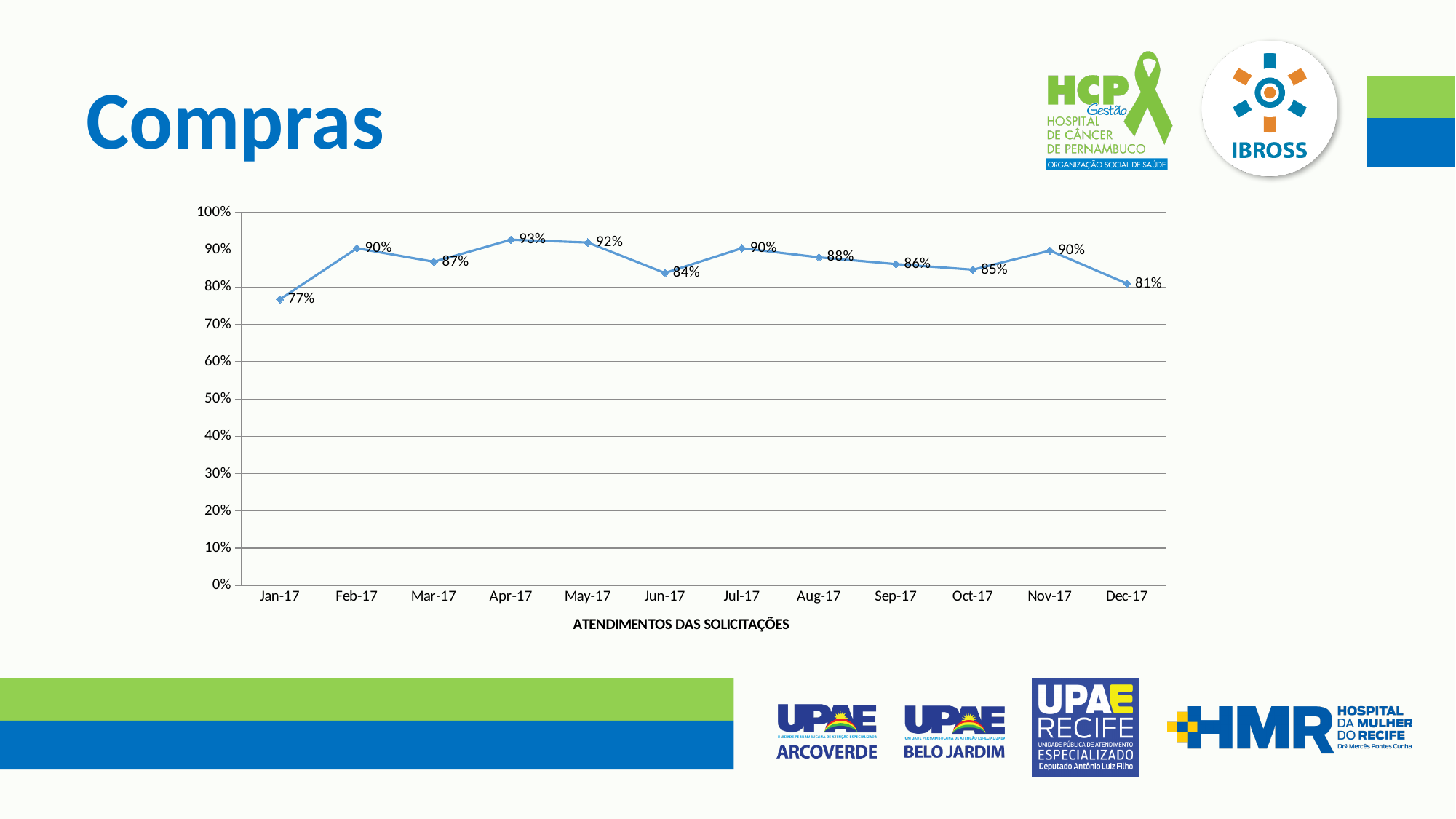
Is the value for Jun-17 greater or less than 80%? greater Which month has the lowest value? Jan-17 What is the difference between the values for Apr-17 and Jun-17? 9% Do the values rise or fall from Jul-17 to Oct-17? fall What kind of chart is shown on the slide? line chart What is the value for Apr-17? 93% What is the label shown below the x axis of the chart? ATENDIMENTOS DAS SOLICITAÇÕES Which month has the highest value? Apr-17 What is the value for Jan-17? 77% Which is larger, the value for Feb-17 or the value for Mar-17? Feb-17 How many months are plotted on the x axis? 12 What is the value for Dec-17? 81%